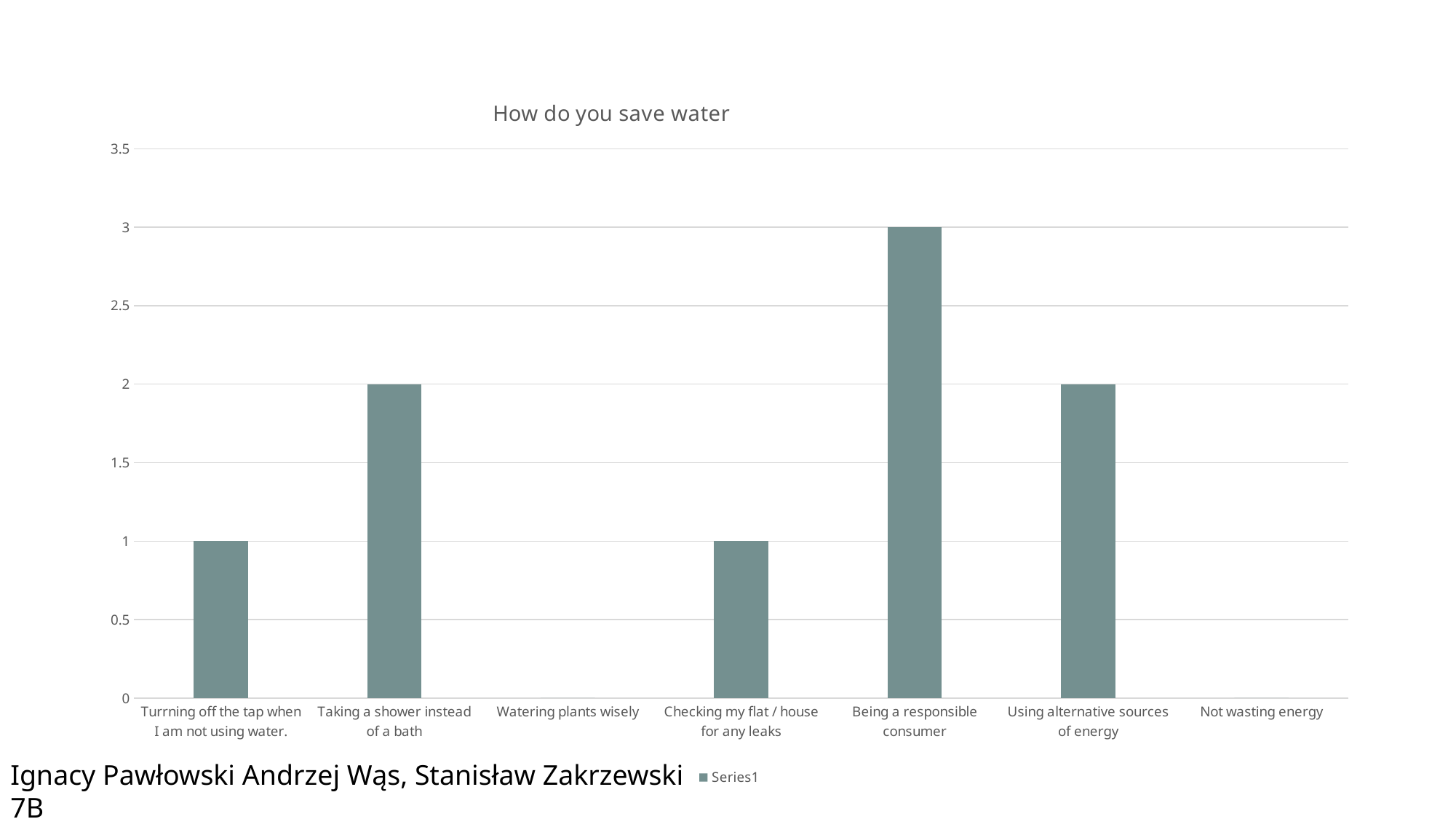
Which category has the highest value? Being a responsible consumer What is the value for "Using alternative sources of energy"? 2 How many categories are shown on the x axis of the chart? 7 Which is larger, the value for "Taking a shower instead of a bath" or the value for "Checking my flat / house for any leaks"? Taking a shower instead of a bath Is the value for "Being a responsible consumer" greater or less than 2.5? greater How many series does the legend list? 1 What is the value for "Checking my flat / house for any leaks"? 1 What kind of chart is shown on the slide? bar chart What is the value for "Taking a shower instead of a bath"? 2 What is the title of the chart? How do you save water What is the value for "Being a responsible consumer"? 3 What is the difference between the values for "Being a responsible consumer" and "Turrning off the tap when I am not using water."? 2